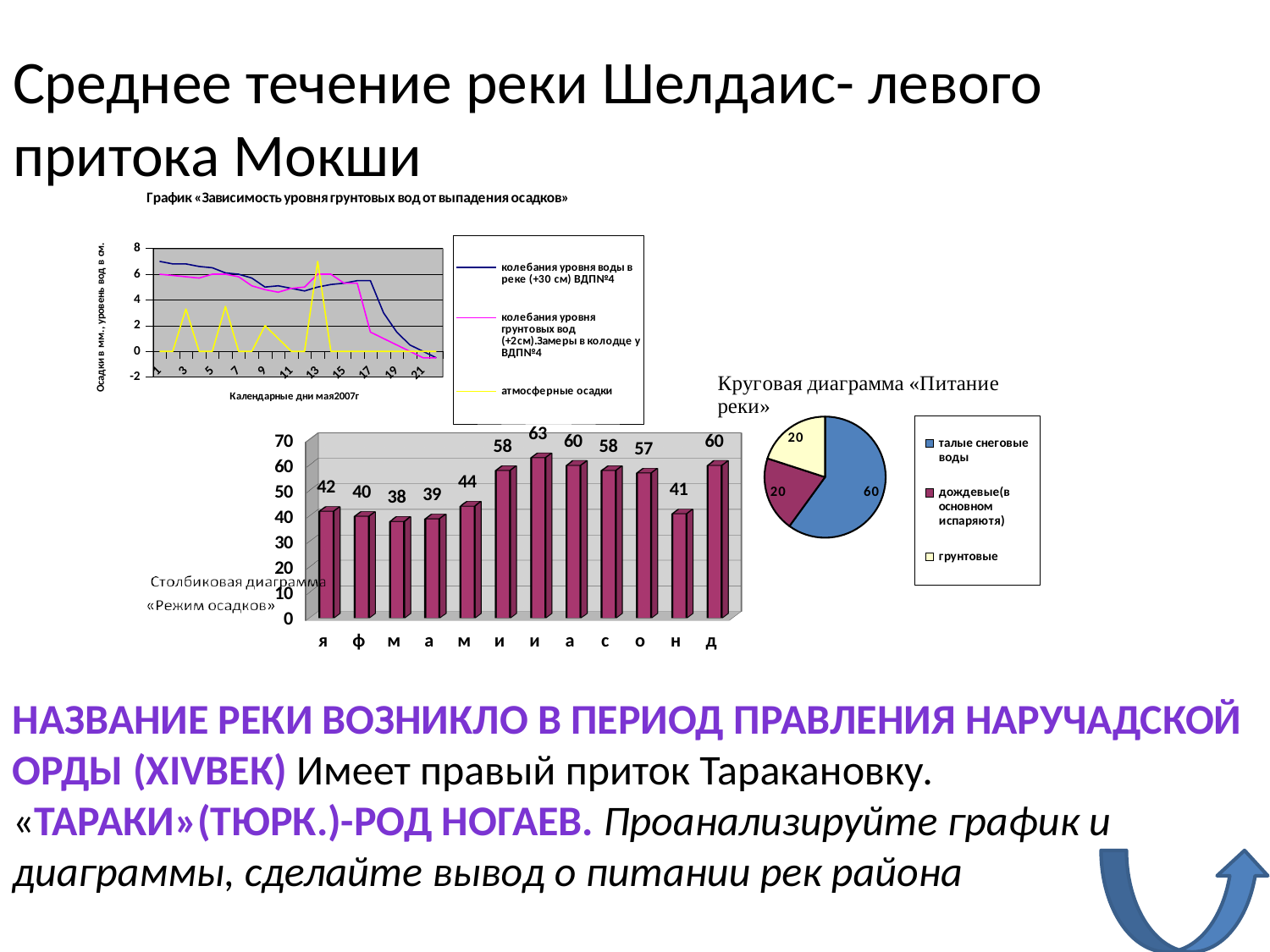
On the bar chart «Режим осадков», how many months (bars) are shown? 12 On the bar chart «Режим осадков», which month has the lowest value? м (38) On the pie chart «Питание реки», what is the value for «талые снеговые воды»? 60 On the pie chart «Питание реки», what share of the total does «грунтовые» (20) represent? 20% What kind of chart is the «Режим осадков» chart? Bar chart On the bar chart «Режим осадков», what is the value for the month labelled «я»? 42 On the bar chart «Режим осадков», which is larger: the value for «н» or the value for «о»? о (57) On the pie chart «Питание реки», which category has the largest slice? талые снеговые воды On the bar chart «Режим осадков», which month has the highest value? и (63) How many series does the legend of the line chart «Зависимость уровня грунтовых вод от выпадения осадков» list? 3 On the bar chart «Режим осадков», what is the difference between the highest value (63) and the lowest value (38)? 25 On the bar chart «Режим осадков», what is the value for the month labelled «д»? 60